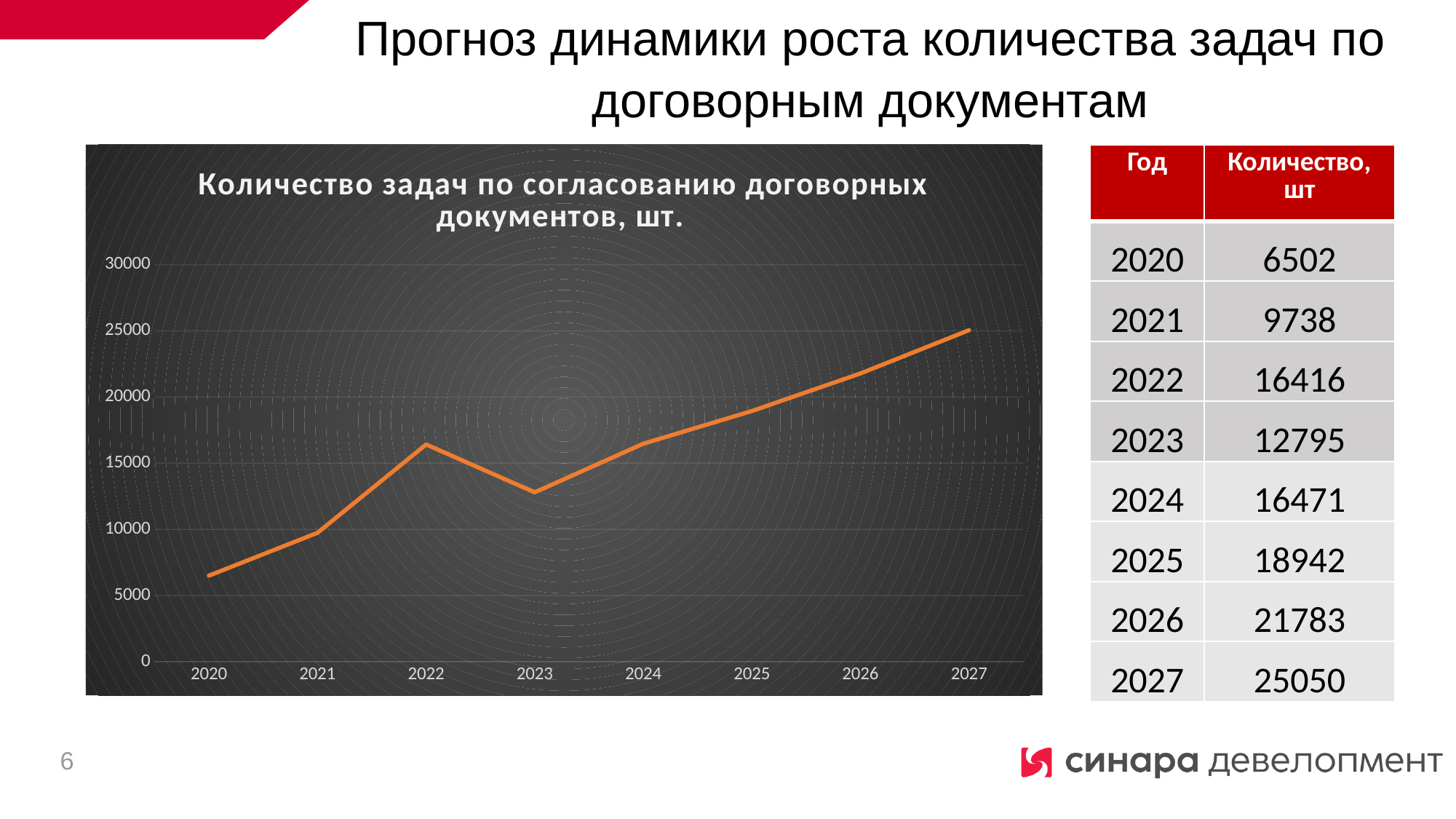
What is the value for 2020? 6502 What kind of chart is shown on the slide? line chart Is the value for 2026 greater or less than 20000? greater What is the title of the chart? Количество задач по согласованию договорных документов, шт. Which year has the highest value? 2027 How many years are plotted on the x axis of the chart? 8 What is the value for 2023? 12795 Which year has the lowest value? 2020 What is the value for 2027? 25050 What is the difference between the values for 2027 and 2020? 18548 Which is larger, the value for 2022 or the value for 2023? 2022 Does the line rise or fall between 2023 and 2027? rises